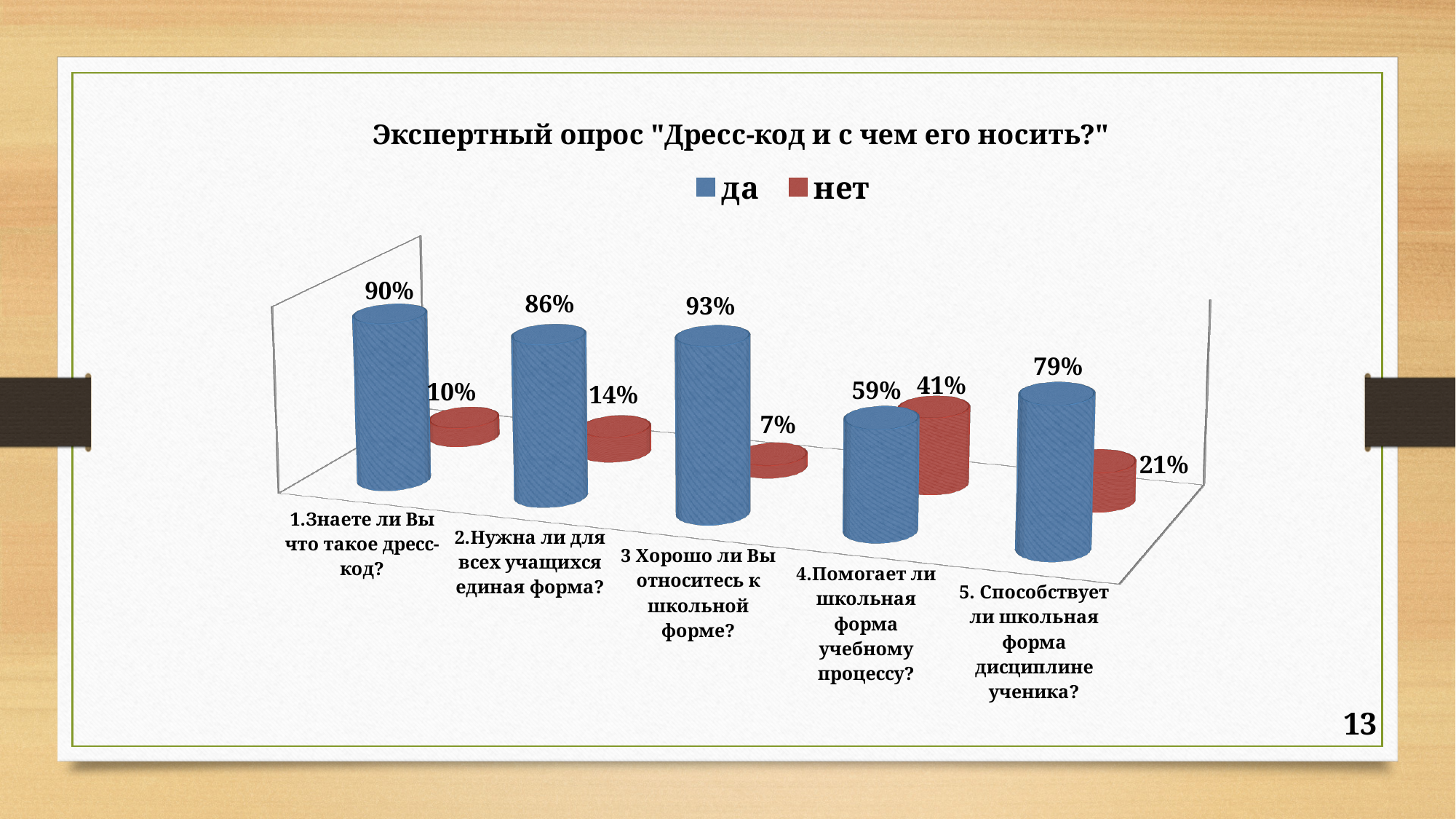
How many questions (categories) are shown on the chart? 5 Which question has the highest "да" value? 3 Хорошо ли Вы относитесь к школьной форме? Which is larger for question 2: the "да" value or the "нет" value? да Which question has the lowest "да" value? 4.Помогает ли школьная форма учебному процессу? What kind of chart is shown on the slide? Bar chart How many series does the legend list? 2 What is the "нет" value for question 4 ("Помогает ли школьная форма учебному процессу?")? 41% Which colour represents the "нет" series? Red What is the difference between the "да" and "нет" values for question 5 ("Способствует ли школьная форма дисциплине ученика?")? 58% What is the title of the chart? Экспертный опрос "Дресс-код и с чем его носить?" What is the "нет" value for question 3 ("Хорошо ли Вы относитесь к школьной форме?")? 7% What is the "да" value for question 1 ("Знаете ли Вы что такое дресс-код?")? 90%